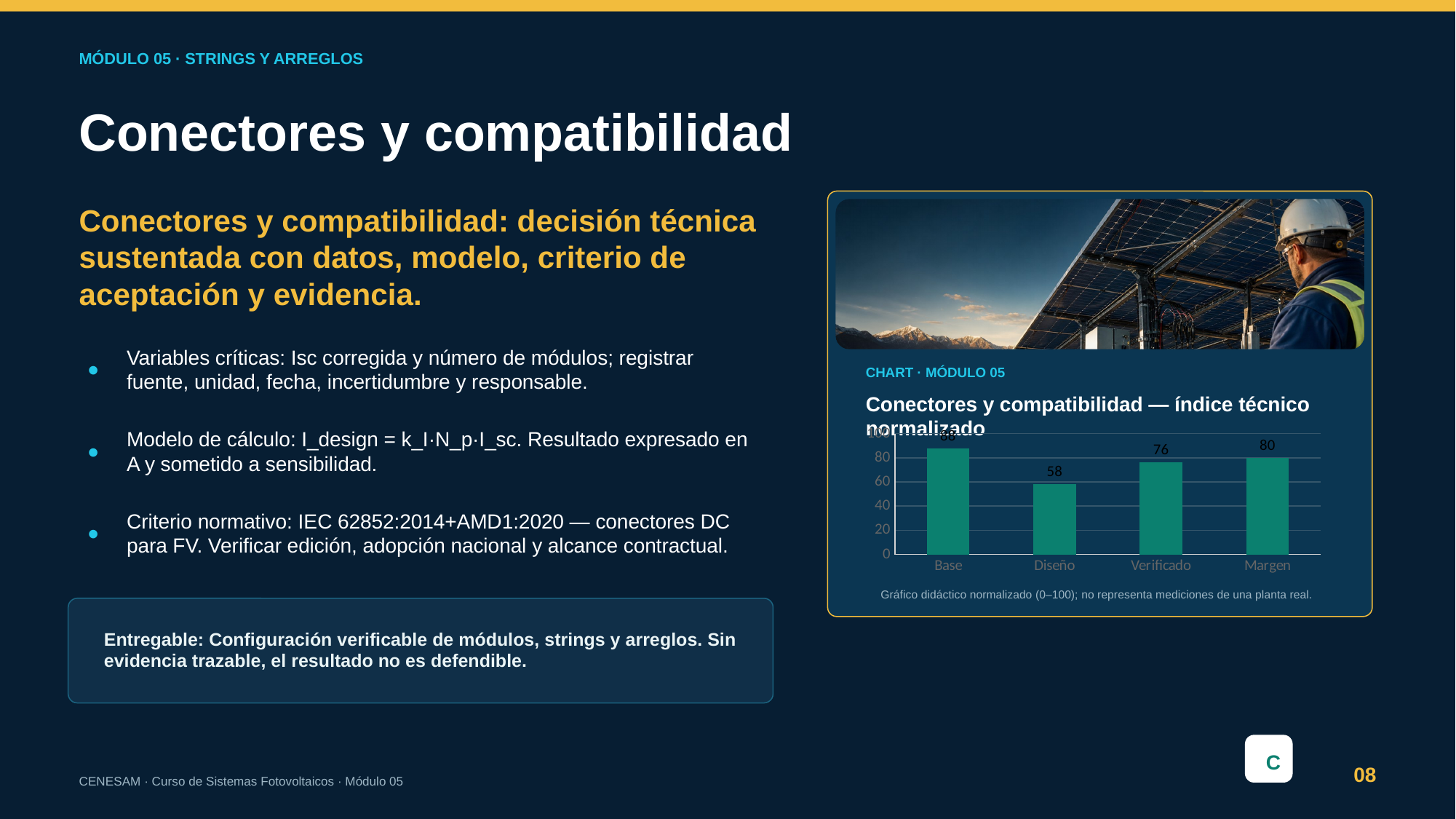
How many categories are shown on the x axis? 4 What is the value for Verificado? 76 What is the title of the chart? Conectores y compatibilidad — índice técnico normalizado Is the value for Base greater or less than 80? greater Which category has the lowest value? Diseño What is the difference between the values for Verificado and Diseño? 18 What is the value for Diseño? 58 What is the difference between the values for Margen and Diseño? 22 What is the value for Margen? 80 Which is larger, the value for Verificado or the value for Diseño? Verificado What kind of chart is shown on the slide? bar chart Which category has the highest value? Base